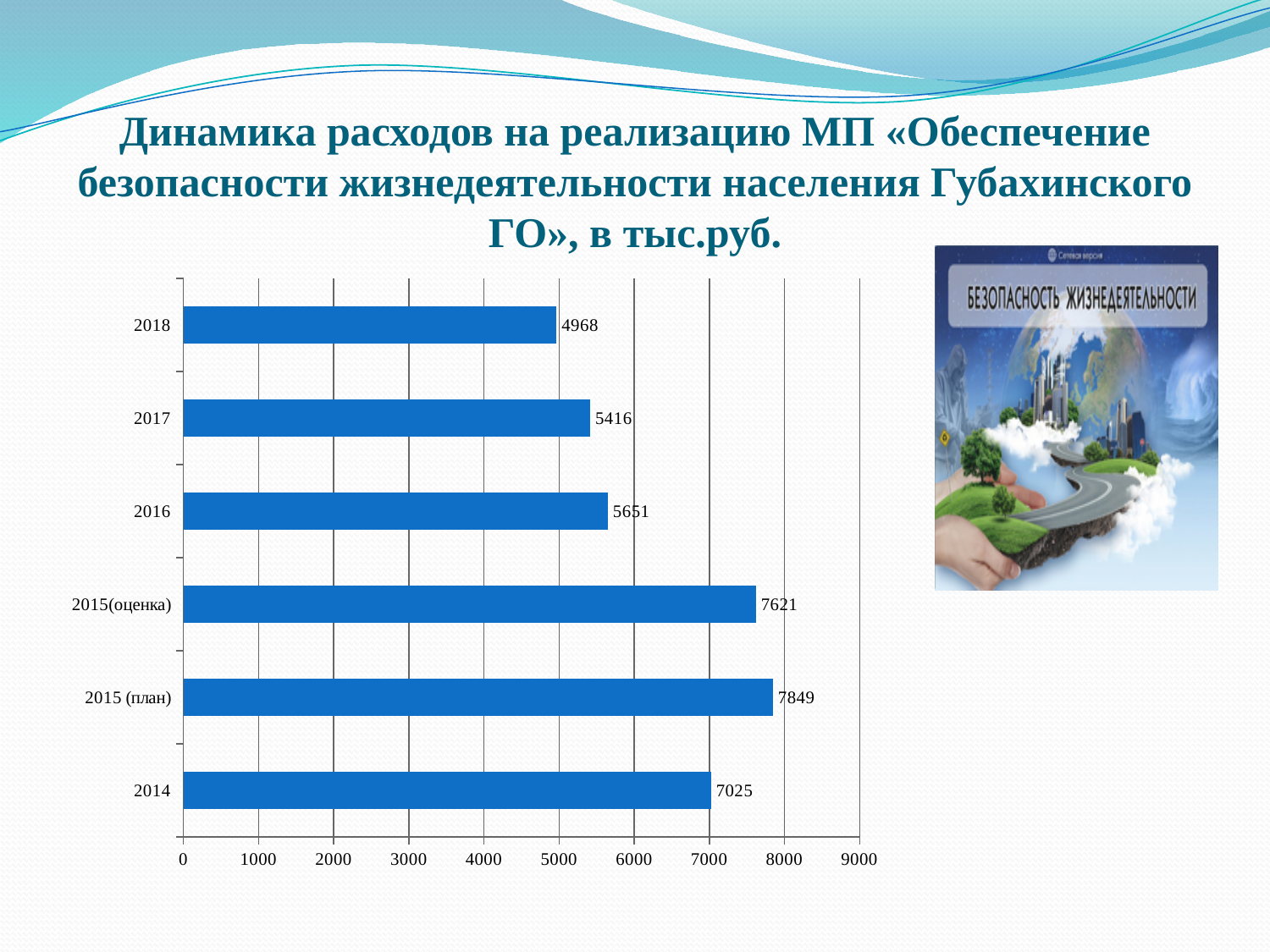
What is the value for 2016? 5651 Which category has the lowest value? 2018 Which category has the highest value? 2015 (план) Is the value for 2014 greater or less than 6000? greater Do the values rise or fall from 2016 to 2018? fall What is the value for 2015 (план)? 7849 What is the difference between the values for 2015 (план) and 2015(оценка)? 228 What kind of chart is shown on the slide? bar chart What is the value for 2018? 4968 What is the difference between the values for 2014 and 2018? 2057 How many categories are shown on the chart? 6 Which is larger, the value for 2016 or the value for 2017? 2016